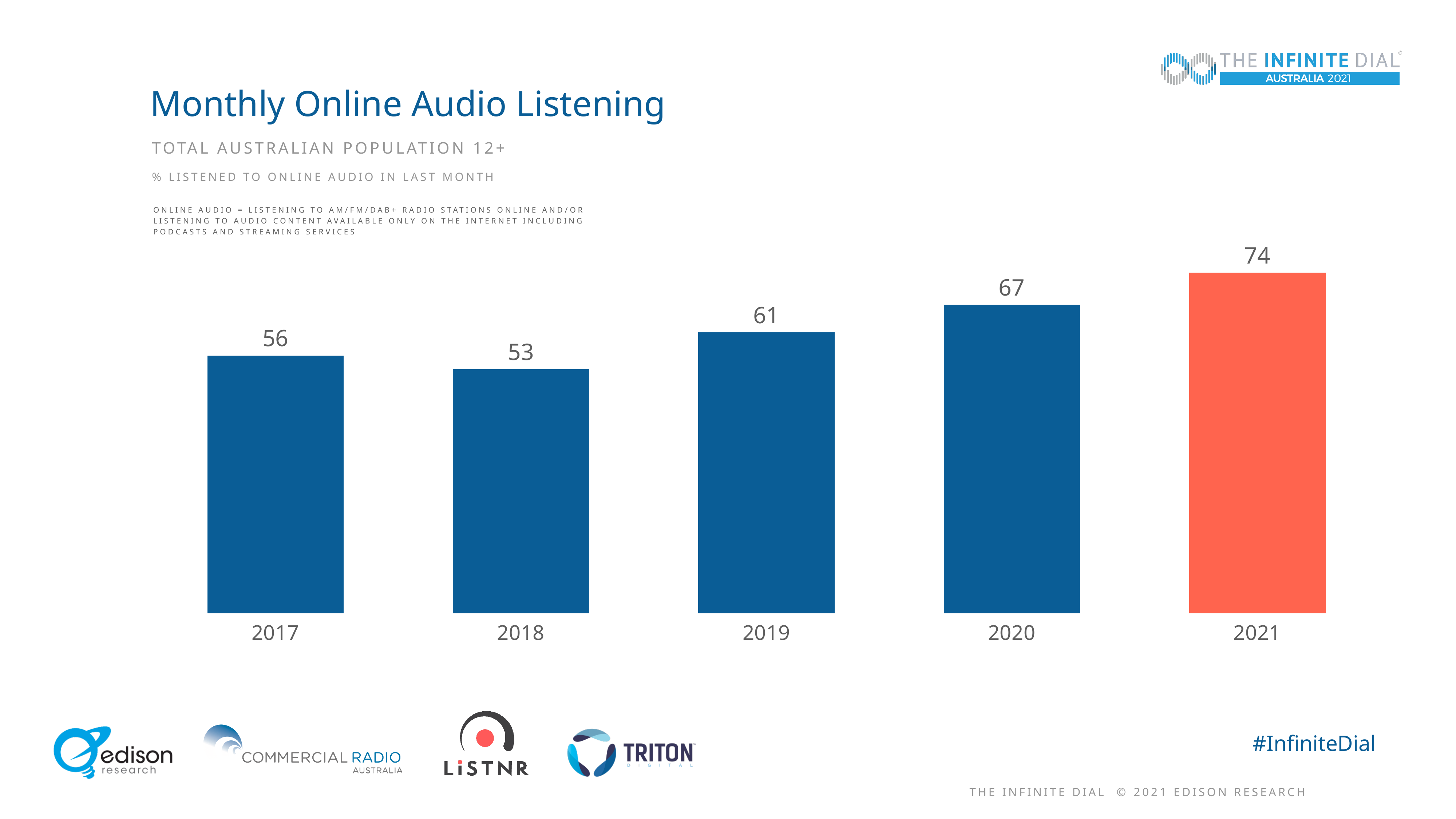
What is the value for 2021? 74 What is the value for 2018? 53 What is the value for 2017? 56 What is the value for 2019? 61 Which year has the highest value? 2021 What kind of chart is shown on the slide? Bar chart Which bar is shown in a different colour (red/orange) from the others? 2021 Which year has the lowest value? 2018 Which is larger, the value for 2019 or the value for 2018? 2019 What is the value for 2020? 67 What is the difference between the values for 2021 and 2017? 18 How many years are shown on the chart? 5